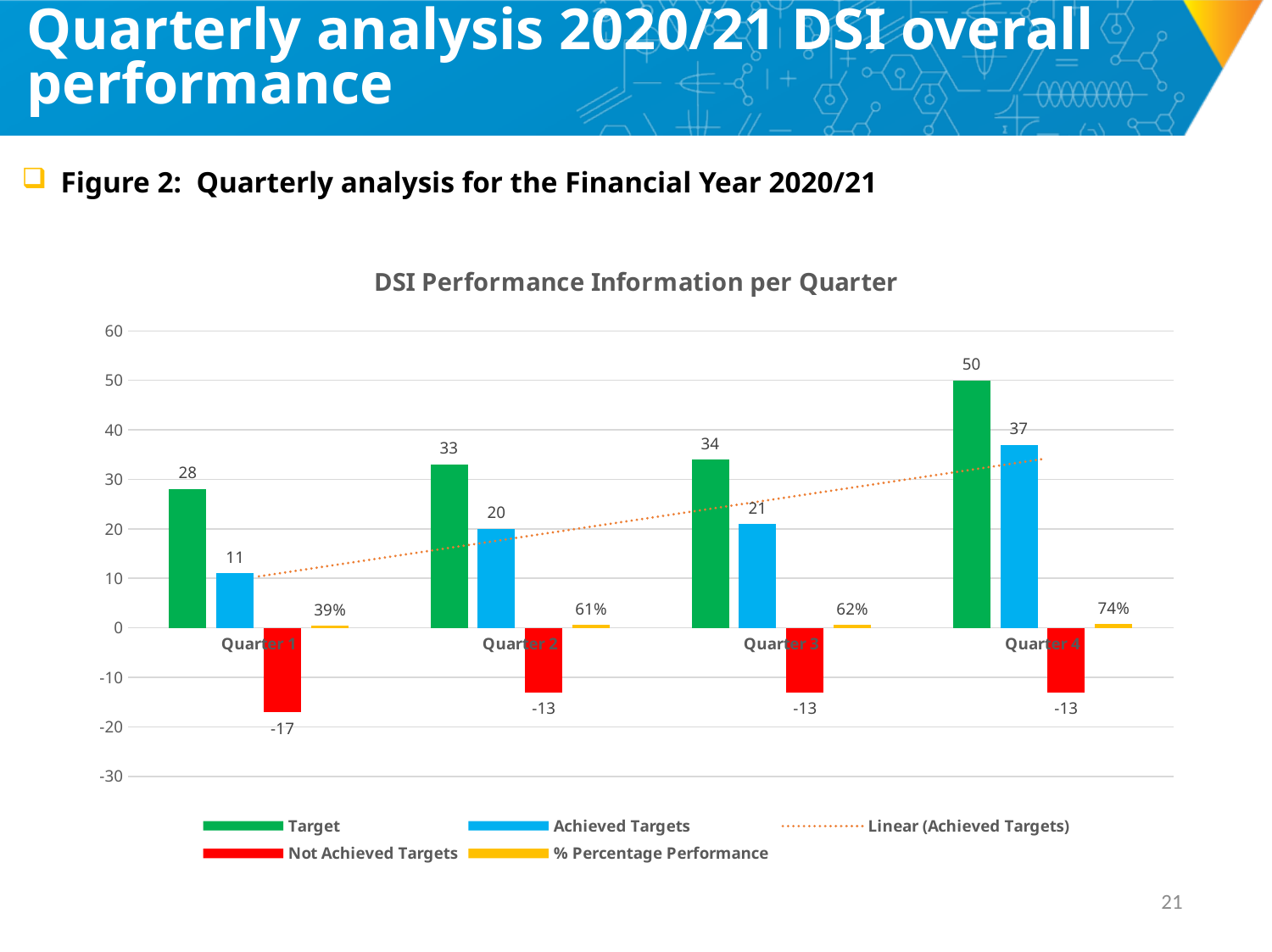
Do the Achieved Targets values rise or fall from Quarter 1 to Quarter 4? Rise What is the Target value for Quarter 4? 50 How many entries does the legend list? 5 What is the Achieved Targets value for Quarter 2? 20 Which is larger, the Achieved Targets value for Quarter 3 or for Quarter 2? Quarter 3 What is the Not Achieved Targets value for Quarter 1? -17 Which quarter has the highest Target value? Quarter 4 What is the % Percentage Performance value for Quarter 1? 39% What is the difference between the Target and Achieved Targets values for Quarter 4? 13 Which quarter has the lowest Achieved Targets value? Quarter 1 What kind of chart is shown on the slide? Bar chart How many quarters are shown on the x axis? 4